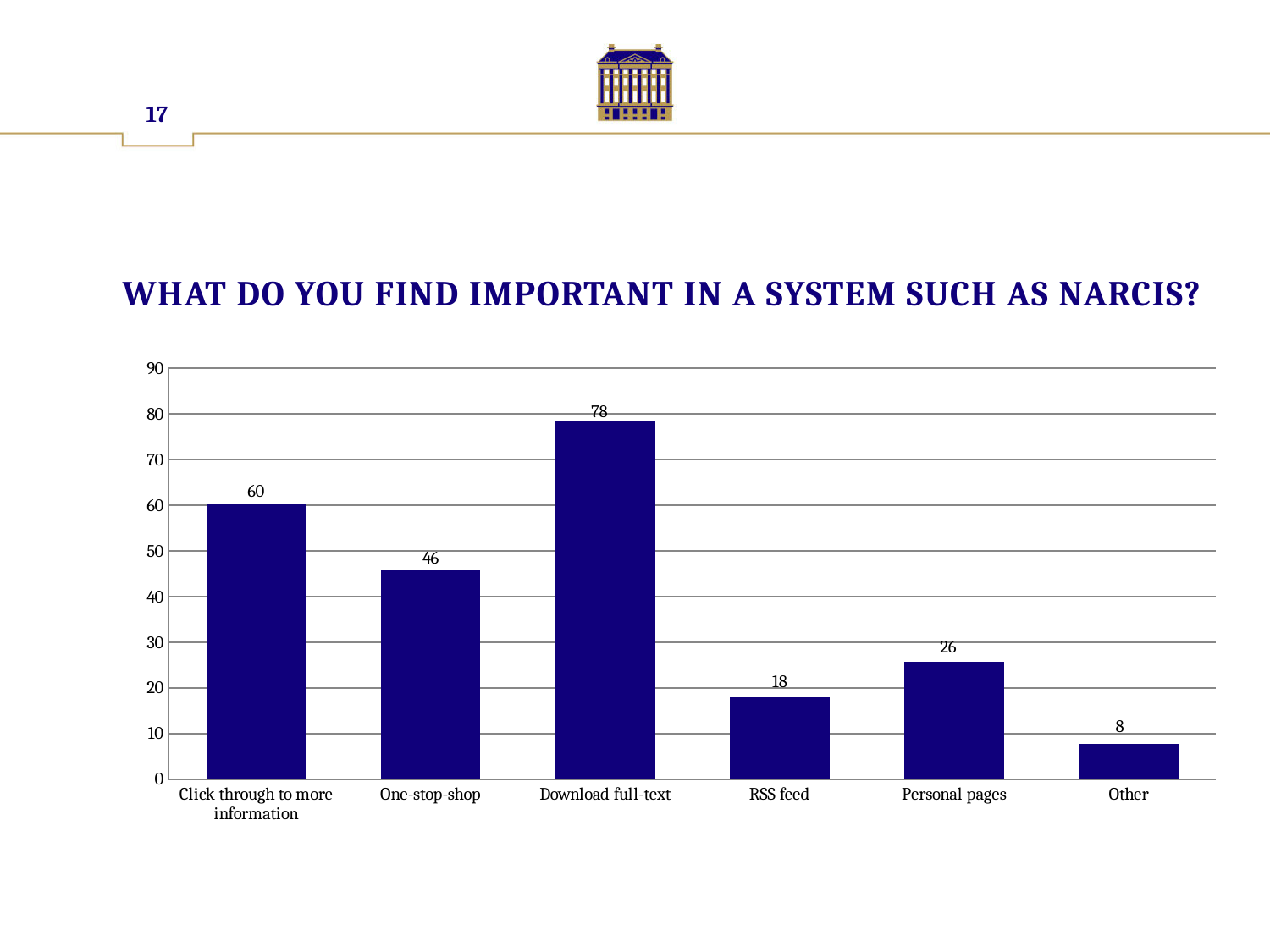
What is the title of the slide above the chart? WHAT DO YOU FIND IMPORTANT IN A SYSTEM SUCH AS NARCIS? How many categories are shown on the x axis? 6 What is the value for RSS feed? 18 What is the difference between the values for Download full-text and One-stop-shop? 32 Which category has the highest value? Download full-text What is the value for Click through to more information? 60 Which is larger, the value for One-stop-shop or the value for Personal pages? One-stop-shop What is the value for Personal pages? 26 What kind of chart is shown on the slide? Bar chart What is the value for Download full-text? 78 Which category has the lowest value? Other What is the difference between the values for Personal pages and RSS feed? 8